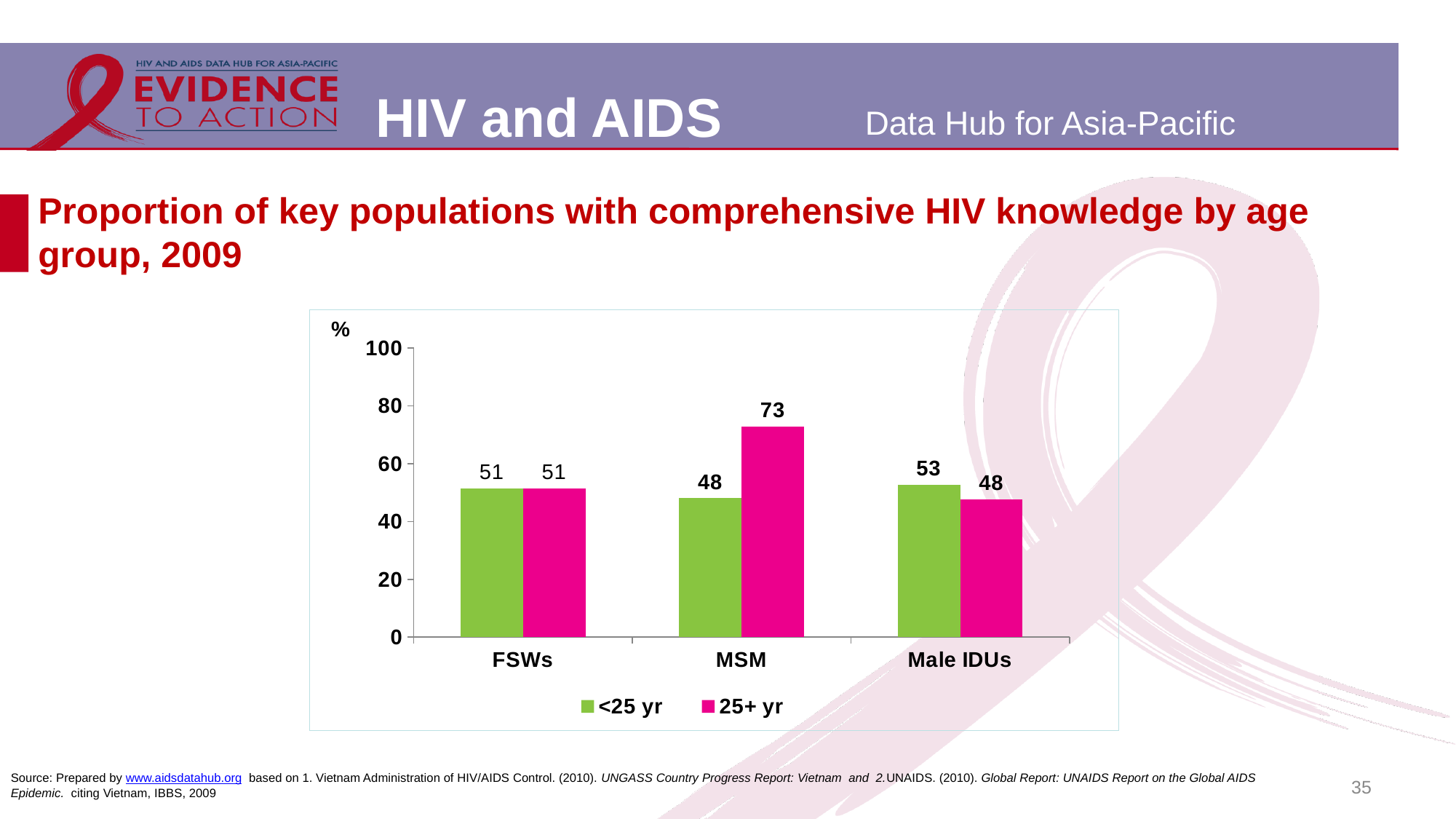
What is the difference between the <25 yr and 25+ yr values for Male IDUs? 5 Which key population has the lowest value in the <25 yr series? MSM What is the value for MSM in the 25+ yr series? 73 What is the value for Male IDUs in the <25 yr series? 53 How many series does the legend list? 2 What is the difference between the 25+ yr and <25 yr values for MSM? 25 What is the value for FSWs in the 25+ yr series? 51 For Male IDUs, which age group has the larger value, <25 yr or 25+ yr? <25 yr Is the value for MSM in the 25+ yr series greater or less than 60? greater What kind of chart is shown on the slide? bar chart How many key population categories are shown on the x axis? 3 Which key population has the highest value in the 25+ yr series? MSM